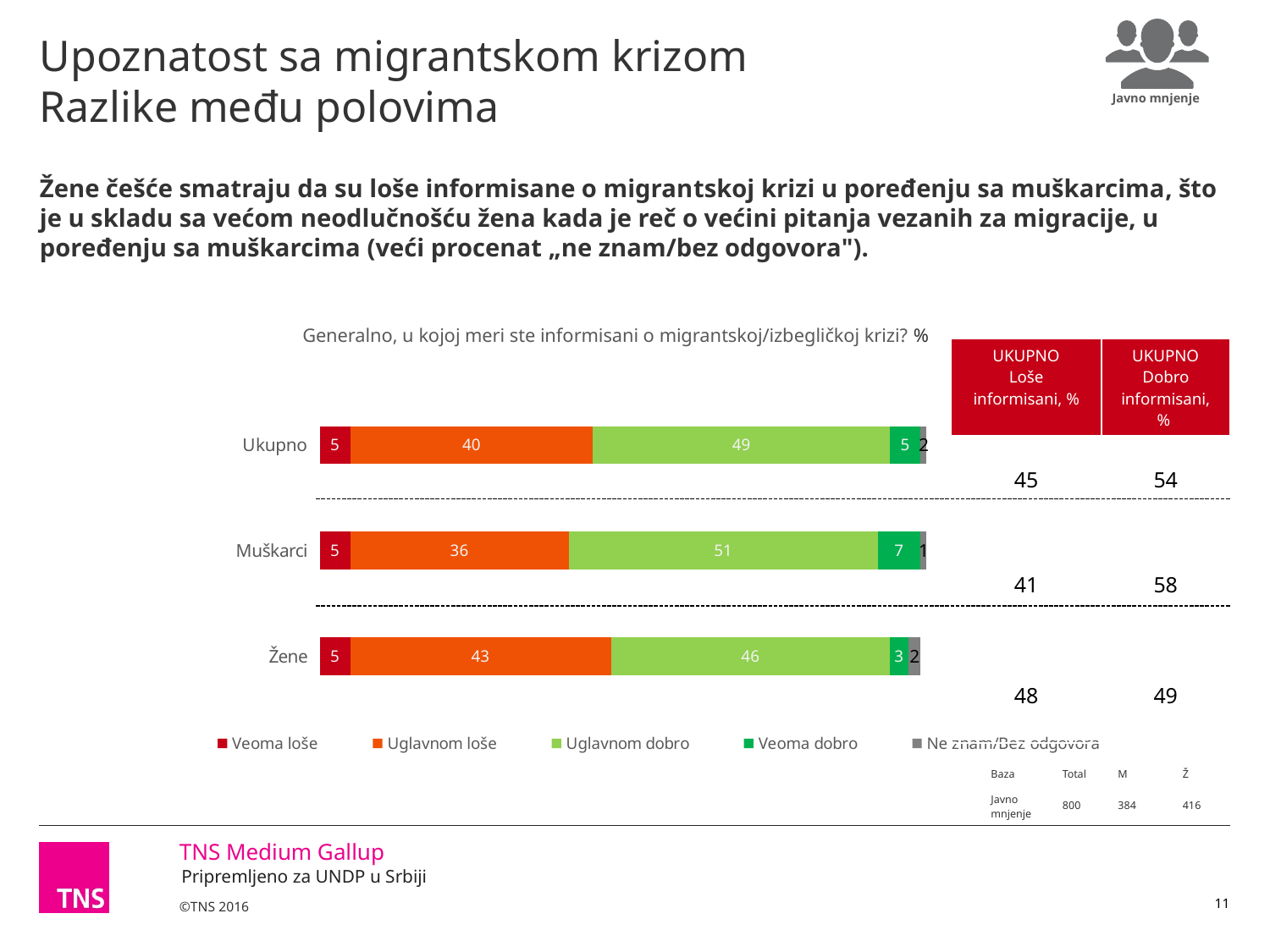
What is the value of 'Veoma dobro' for Ukupno? 5 What is the 'UKUPNO Dobro informisani, %' value shown for Muškarci? 58 How many series does the chart legend list? 5 Is the 'Uglavnom dobro' value larger for Ukupno or for Žene? Ukupno What is the total of the stacked bar for Muškarci? 100 What is the value of 'Uglavnom dobro' for Žene? 46 Which category has the highest value for 'Uglavnom dobro'? Muškarci What type of chart is shown on the slide? Stacked bar chart What is the difference between the 'Uglavnom loše' values for Žene and Muškarci? 7 What is the value of 'Uglavnom loše' for Muškarci? 36 How many categories (groups) are plotted on the chart? 3 Which category has the lowest value for 'Veoma dobro'? Žene